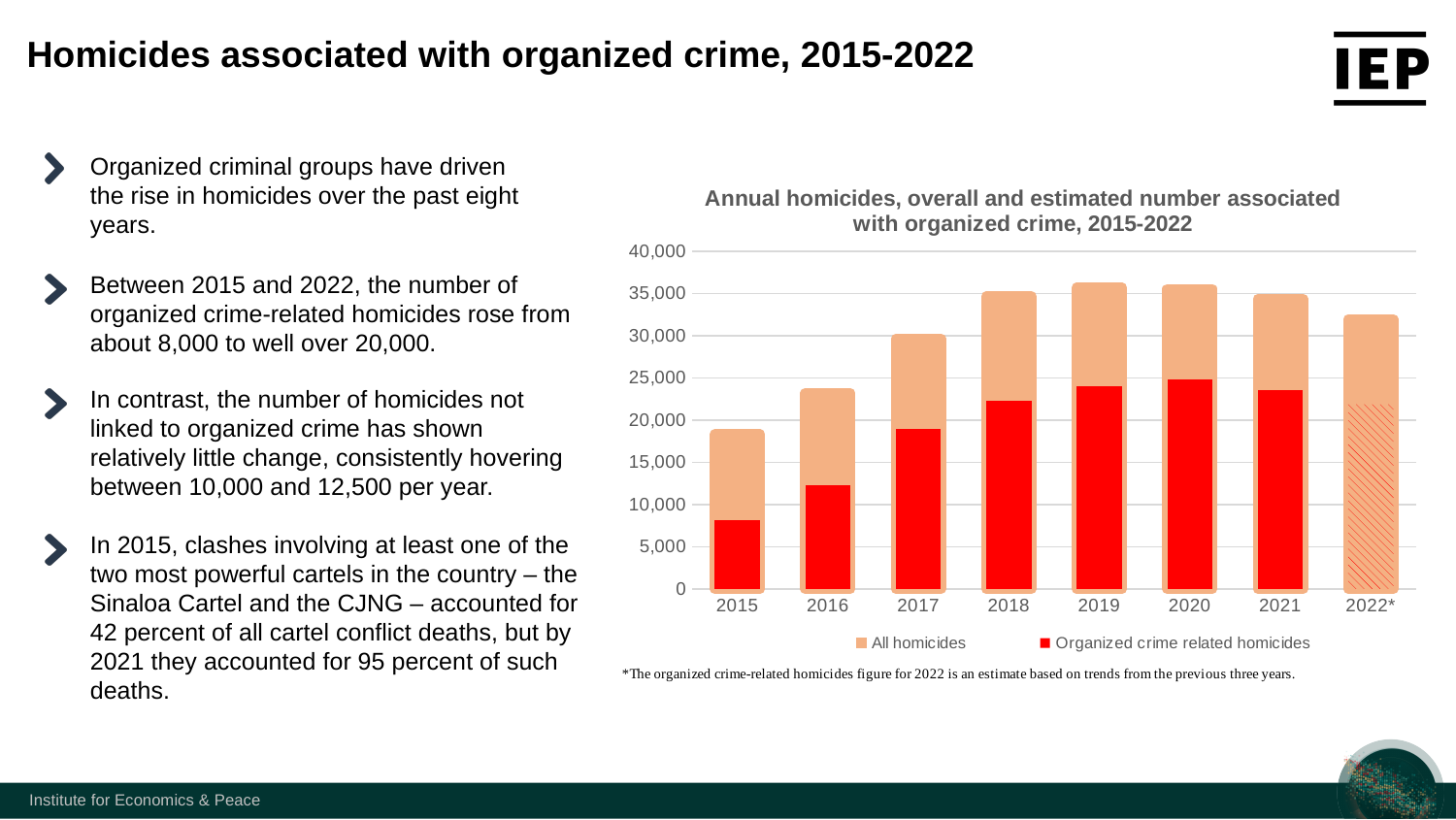
Is the value for All homicides in 2015 greater or less than 20,000? less What kind of chart is shown on the slide? Bar chart Which is larger, the value for All homicides in 2016 or in 2017? 2017 Which year on the x axis is marked with an asterisk to indicate an estimate? 2022* Is the value for All homicides in 2018 greater or less than 30,000? greater Is the value for Organized crime related homicides in 2019 greater or less than 20,000? greater Which year has the lowest value for All homicides? 2015 Which year has the lowest value for Organized crime related homicides? 2015 Do the values for All homicides rise or fall from 2015 to 2019? rise How many years are shown on the x axis of the chart? 8 How many series does the chart's legend list? 2